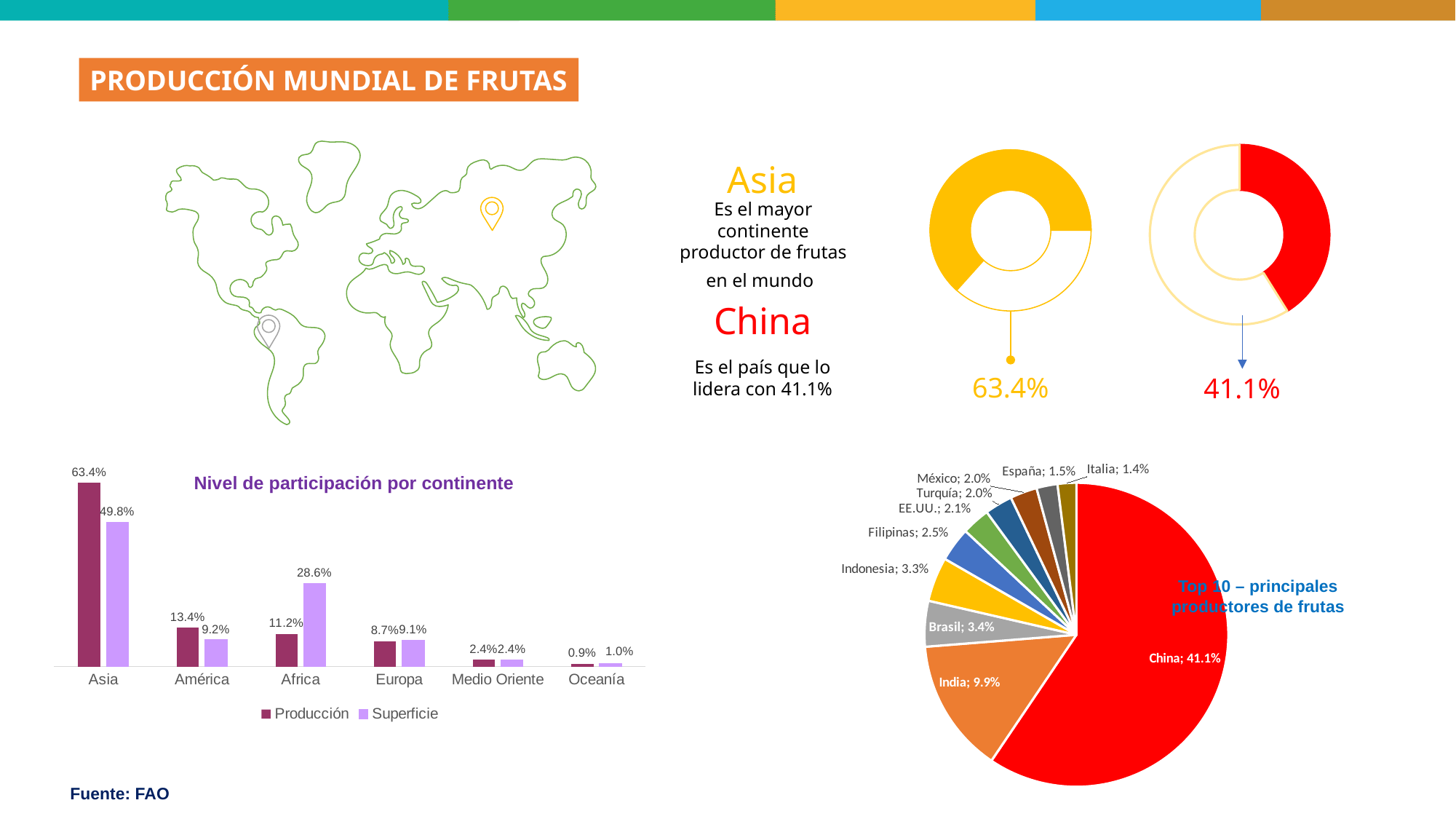
What kind of chart is 'Nivel de participación por continente'? Bar chart In the 'Nivel de participación por continente' chart, is the Producción value for América larger or the Superficie value for América? Producción How many continents are shown on the x axis of the 'Nivel de participación por continente' chart? 6 In the 'Nivel de participación por continente' chart, which continent has the highest Producción value? Asia What percentage is shown below the red donut chart at the top right of the slide? 41.1% In the 'Nivel de participación por continente' chart, which continent has the lowest Superficie value? Oceanía How many series does the legend of the 'Nivel de participación por continente' chart list? 2 In the 'Top 10 – principales productores de frutas' pie chart, what share does India have? 9.9% In the 'Top 10 – principales productores de frutas' pie chart, which country has the smallest labelled share? Italia In the 'Nivel de participación por continente' chart, what is the Producción value for Asia? 63.4% In the 'Nivel de participación por continente' chart, what is the Superficie value for Africa? 28.6% In the 'Nivel de participación por continente' chart, what is the difference between the Producción and Superficie values for Asia? 13.6%